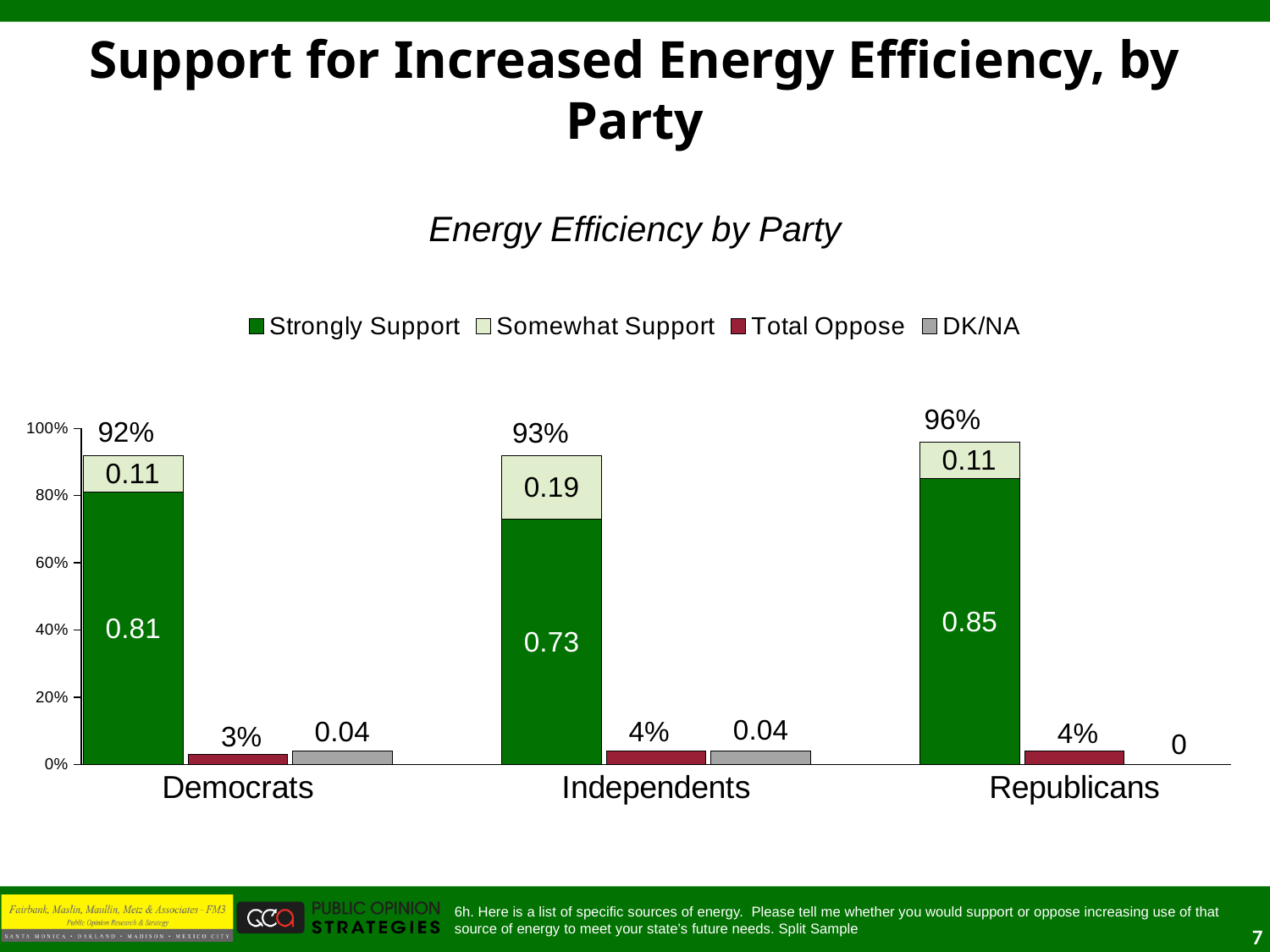
What is the difference between the Strongly Support values for Republicans and Independents? 0.12 How many series does the legend list? 4 Which party has the lowest Strongly Support value? Independents What is the Somewhat Support value for Independents? 0.19 What is the DK/NA value for Republicans? 0 What kind of chart is shown on the slide? Bar chart What is the Strongly Support value for Democrats? 0.81 What is the Total Oppose value for Republicans? 4% Which party has the highest Strongly Support value? Republicans What is the total support (Strongly plus Somewhat) shown above the stacked bar for Republicans? 96% Which is larger, the Somewhat Support value for Independents or for Democrats? Independents How many party categories are shown on the x axis? 3